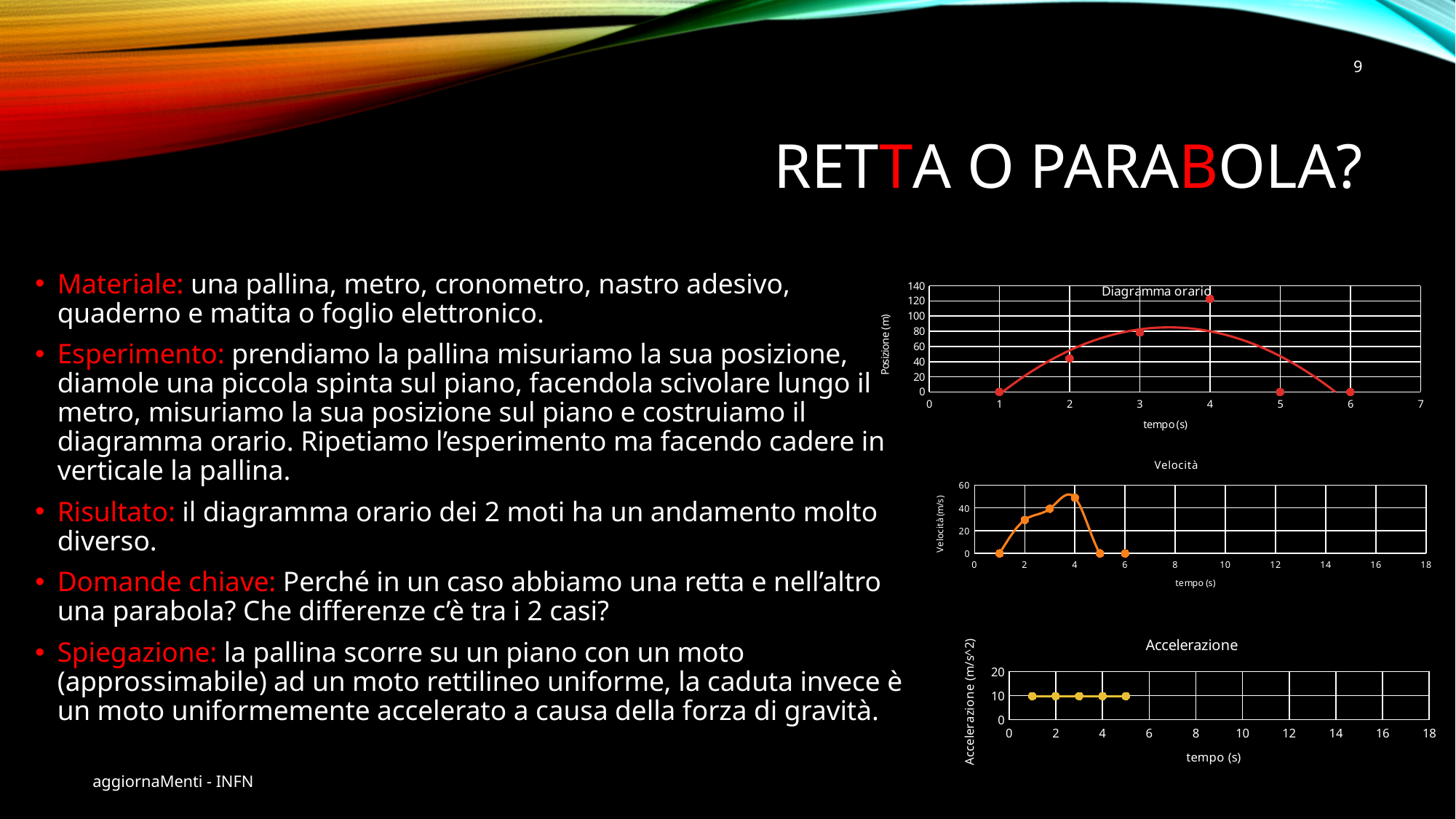
What is the y-axis label of the "Diagramma orario" chart? Posizione (m) In the "Accelerazione" chart, do the values rise, fall or stay constant as tempo increases? stay constant How many data points are plotted in the "Accelerazione" chart? 5 In the "Velocità" chart, is the value at tempo 2 s greater or less than 20? greater In the "Diagramma orario" chart, at which tempo value is the position highest? 4 In the "Diagramma orario" chart, is the position at tempo 4 s greater or less than 100? greater In the "Diagramma orario" chart, what is the position value at tempo 6 s? 0 How many data points are plotted in the "Velocità" chart? 6 In the "Diagramma orario" chart, which has the larger position: tempo 2 s or tempo 3 s? tempo 3 s What kind of chart is the "Diagramma orario" chart? line chart In the "Velocità" chart, is the value at tempo 4 s greater or less than 40? greater